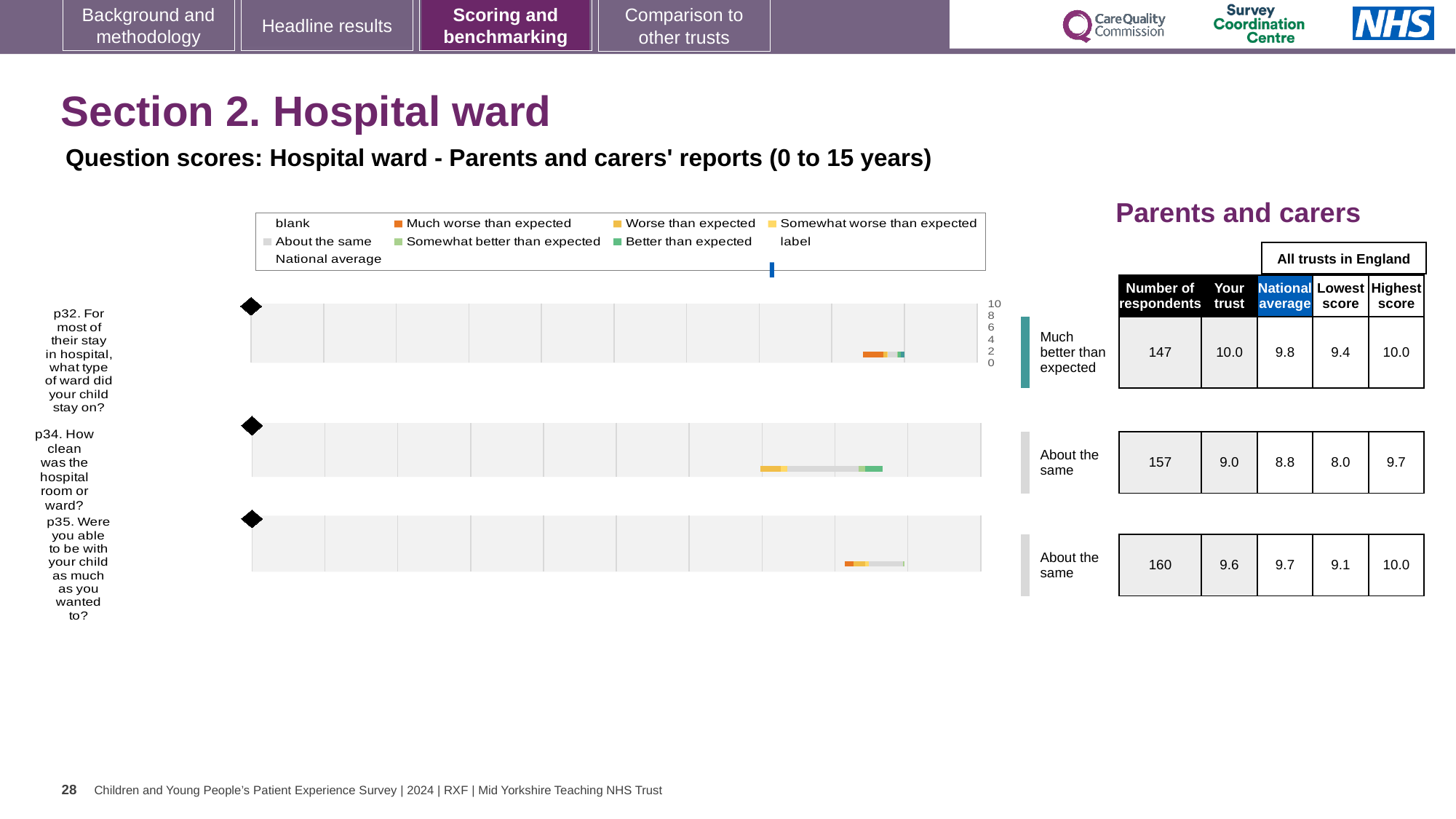
What kind of chart is used to show the question scores for p32, p34 and p35? bar chart How many questions are plotted in the charts on this slide? 3 What is the 'Your trust' score for p34 (how clean was the hospital room or ward)? 9.0 In the chart legend, what colour represents 'Much worse than expected'? orange What benchmark category is shown for p32? Much better than expected Which question has the lowest 'Your trust' score? p34 Which question has the highest 'Your trust' score? p32 For p35, which is larger: the 'Your trust' score or the national average? National average What is the national average score for p35 (were you able to be with your child as much as you wanted to)? 9.7 What is the subtitle above the charts on this slide? Question scores: Hospital ward - Parents and carers' reports (0 to 15 years) How many respondents are shown for p32 (what type of ward did your child stay on)? 147 For p32, what is the difference between the highest score and the lowest score across all trusts in England? 0.6